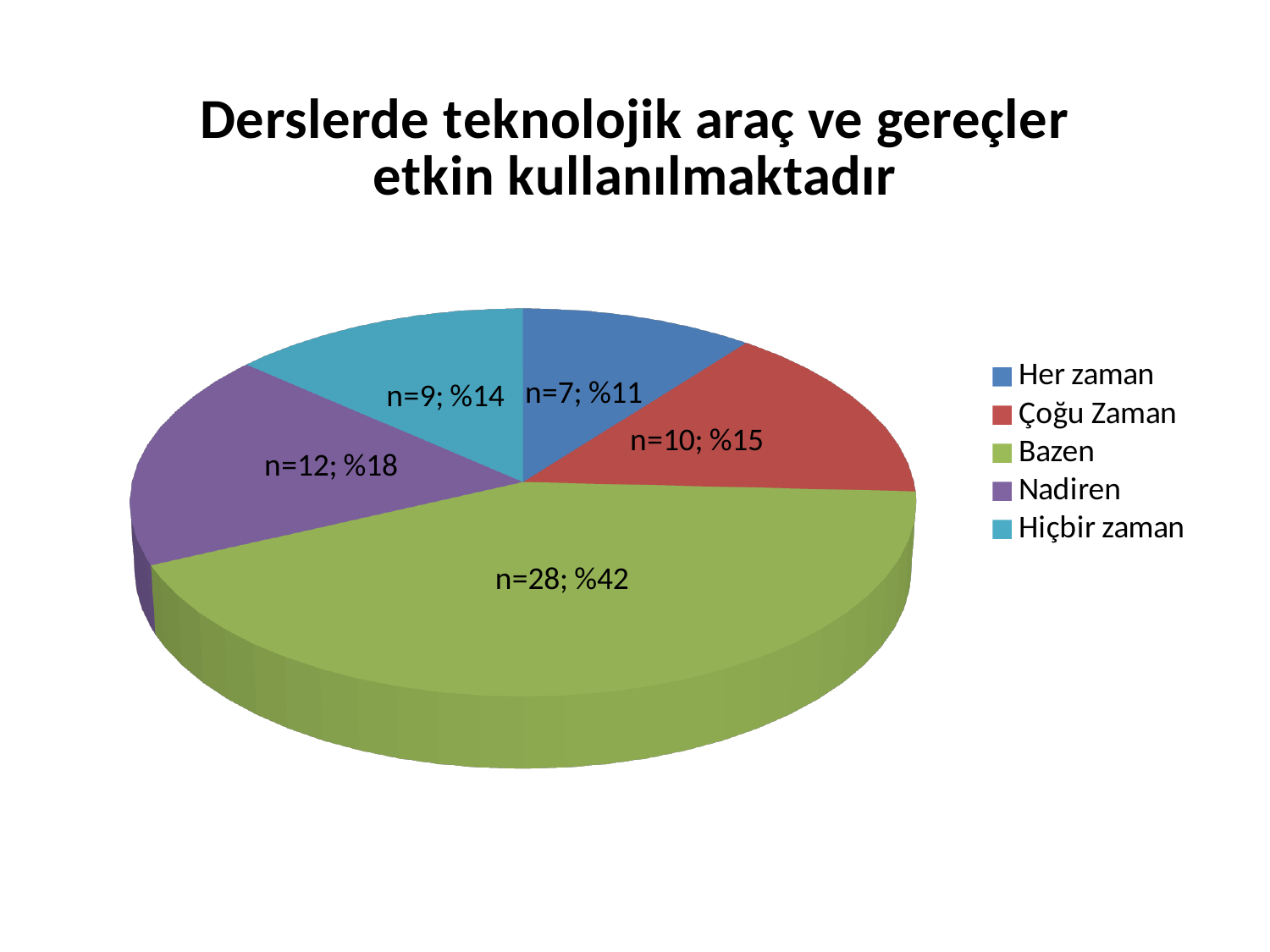
What percentage share does the Nadiren slice have? %18 Which category has the smallest slice? Her zaman Which is larger, the Nadiren slice or the Hiçbir zaman slice? Nadiren What is the value (n) for the Hiçbir zaman slice? n=9 How many slices does the pie chart have? 5 What is the difference in n between Bazen and Çoğu Zaman? 18 What is the title of the chart? Derslerde teknolojik araç ve gereçler etkin kullanılmaktadır What percentage share does the Bazen slice have? %42 What is the value (n) for the Bazen slice? n=28 Which category has the largest slice? Bazen What kind of chart is shown on the slide? pie chart What is the value (n) for the Her zaman slice? n=7